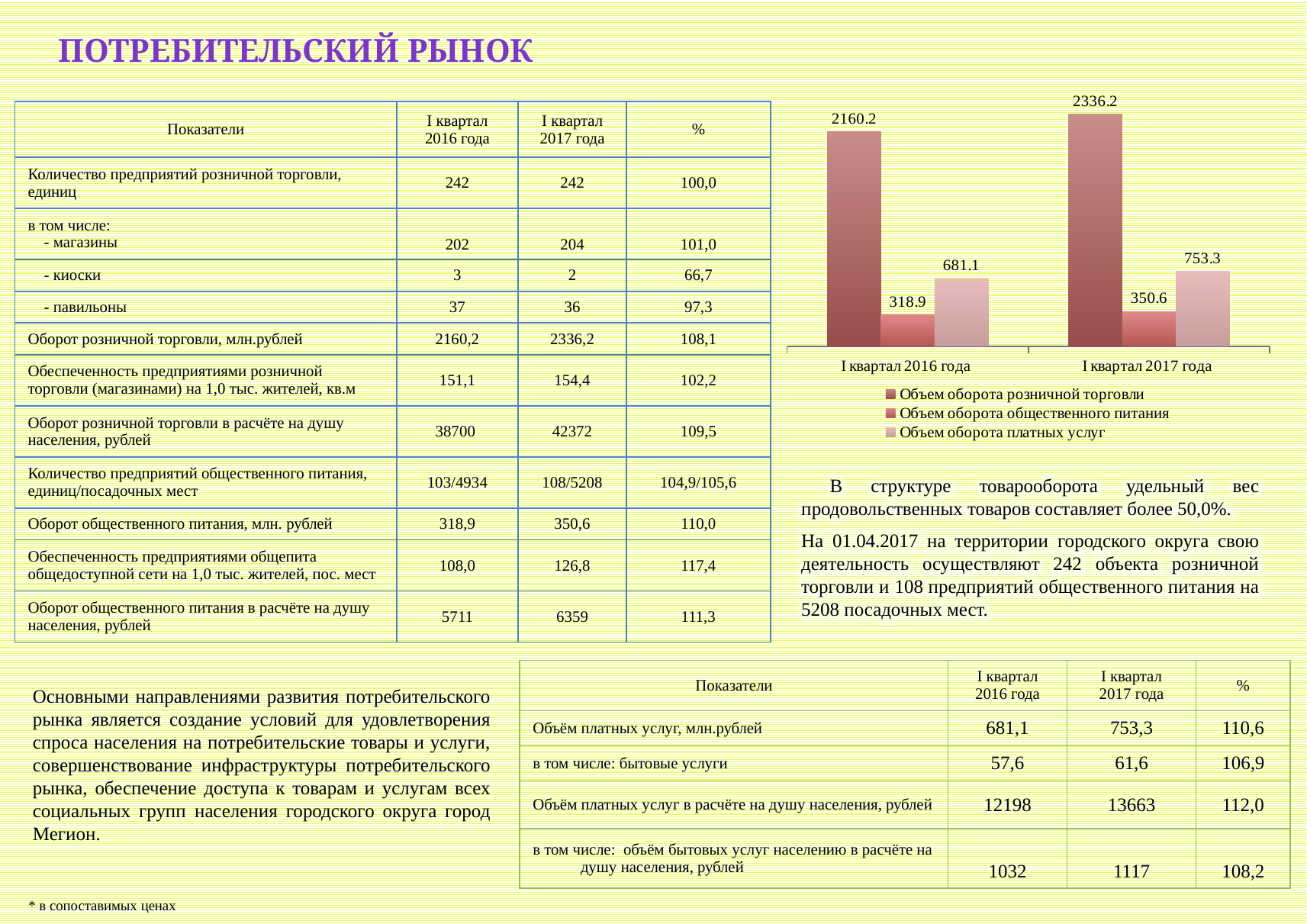
What is the value of Объем оборота платных услуг for I квартал 2017 года? 753.3 How many categories are shown on the x axis of the chart? 2 Which series is shown in the lightest pink colour in the chart? Объем оборота платных услуг Which series has the lowest value in I квартал 2017 года? Объем оборота общественного питания How many series does the chart legend list? 3 What is the value of Объем оборота общественного питания for I квартал 2016 года? 318.9 What type of chart is shown on the slide? bar chart Which series has the highest value in I квартал 2016 года? Объем оборота розничной торговли What is the value of Объем оборота розничной торговли for I квартал 2017 года? 2336.2 What is the difference between Объем оборота розничной торговли in I квартал 2017 года and I квартал 2016 года? 176.0 Does Объем оборота общественного питания rise or fall from I квартал 2016 года to I квартал 2017 года? rise Which is larger: Объем оборота платных услуг in I квартал 2016 года or in I квартал 2017 года? I квартал 2017 года